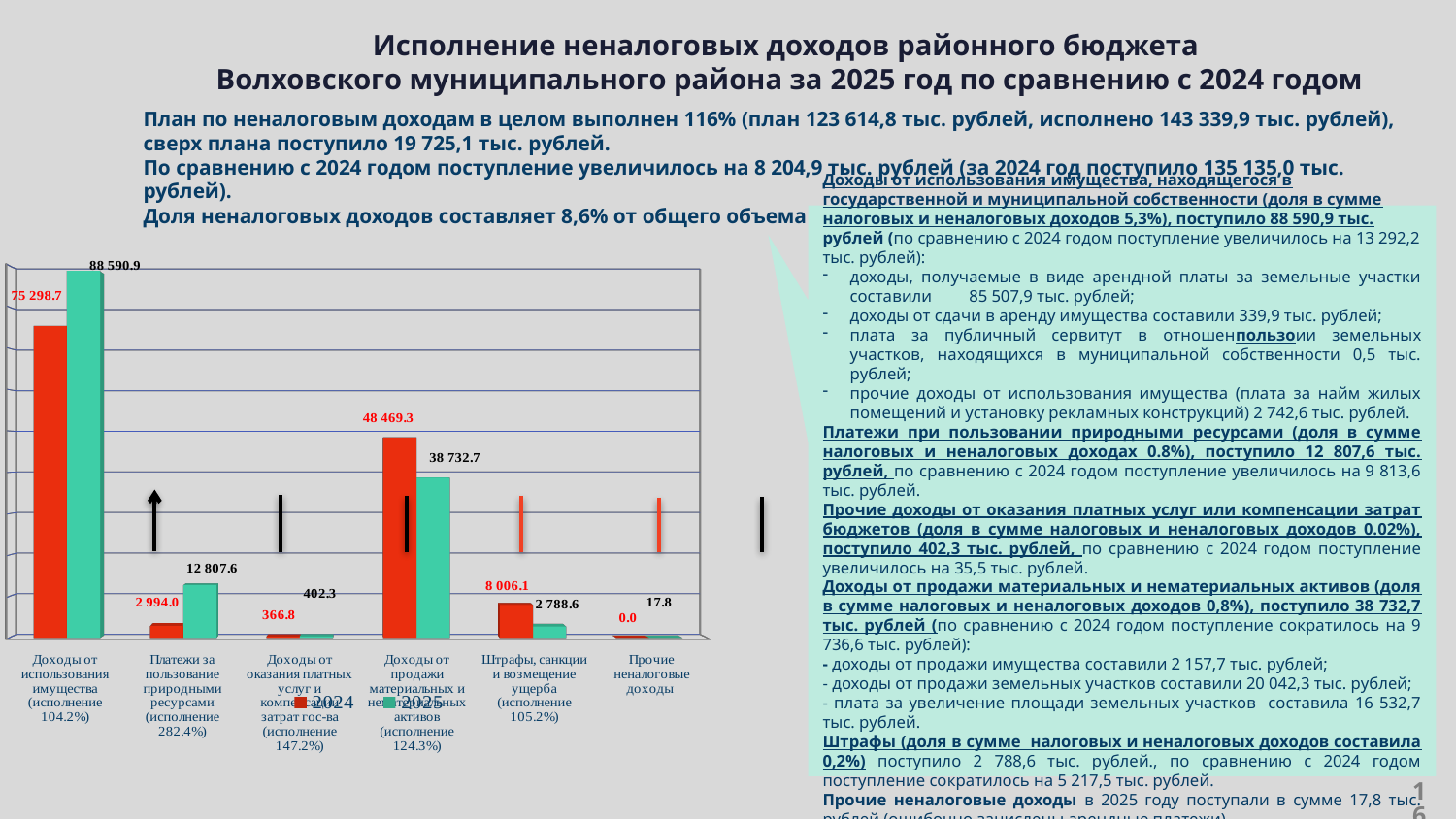
For 'Доходы от продажи материальных и нематериальных активов', which year has the larger value, 2024 or 2025? 2024 What is the 2025 value for 'Штрафы, санкции и возмещение ущерба'? 2 788.6 What is the 2025 value for 'Доходы от использования имущества'? 88 590.9 What type of chart is shown on the slide? bar chart How many categories are shown on the x axis of the chart? 6 Which category has the highest 2025 value? Доходы от использования имущества How many series does the chart's legend list? 2 Which colour represents the 2025 series in the chart? green What is the 2024 value for 'Прочие неналоговые доходы'? 0.0 What is the difference between the 2025 and 2024 values for 'Платежи за пользование природными ресурсами'? 9 813.6 Which category has the lowest 2024 value? Прочие неналоговые доходы What is the 2024 value for 'Платежи за пользование природными ресурсами'? 2 994.0